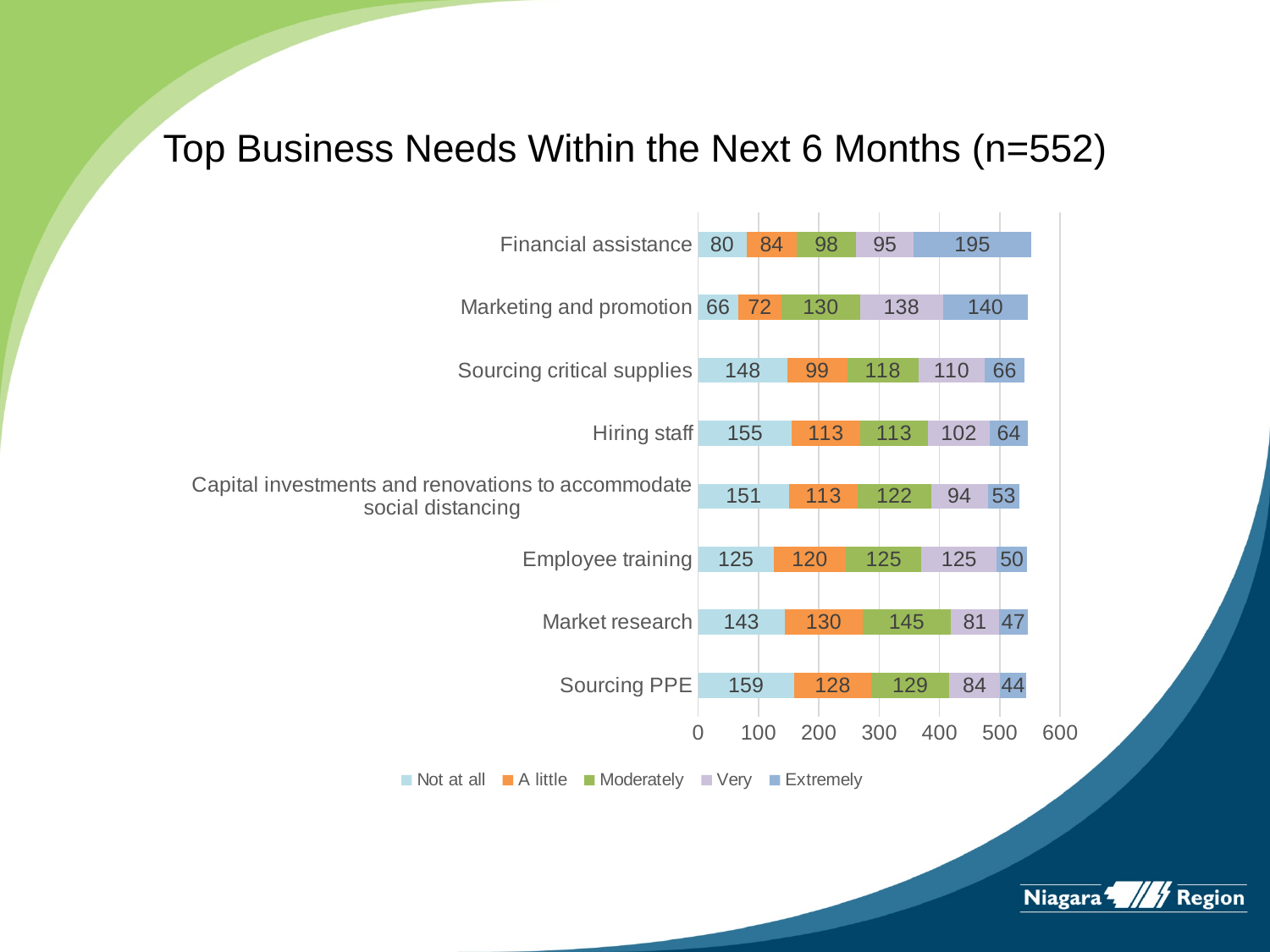
What is the value of the "Very" series for Marketing and promotion? 138 What is the total of the stacked bar for Financial assistance? 552 What is the title of the chart? Top Business Needs Within the Next 6 Months (n=552) What kind of chart is shown on the slide? Stacked bar chart How many series does the legend list? 5 What is the value of the "Not at all" series for Sourcing PPE? 159 How many business need categories are shown in the chart? 8 Which category has the lowest "Extremely" value? Sourcing PPE What is the difference between the "Extremely" values for Financial assistance and Marketing and promotion? 55 Which category has the highest "Extremely" value? Financial assistance What is the value of the "Extremely" series for Financial assistance? 195 Which has the larger "Not at all" value, Hiring staff or Sourcing PPE? Sourcing PPE